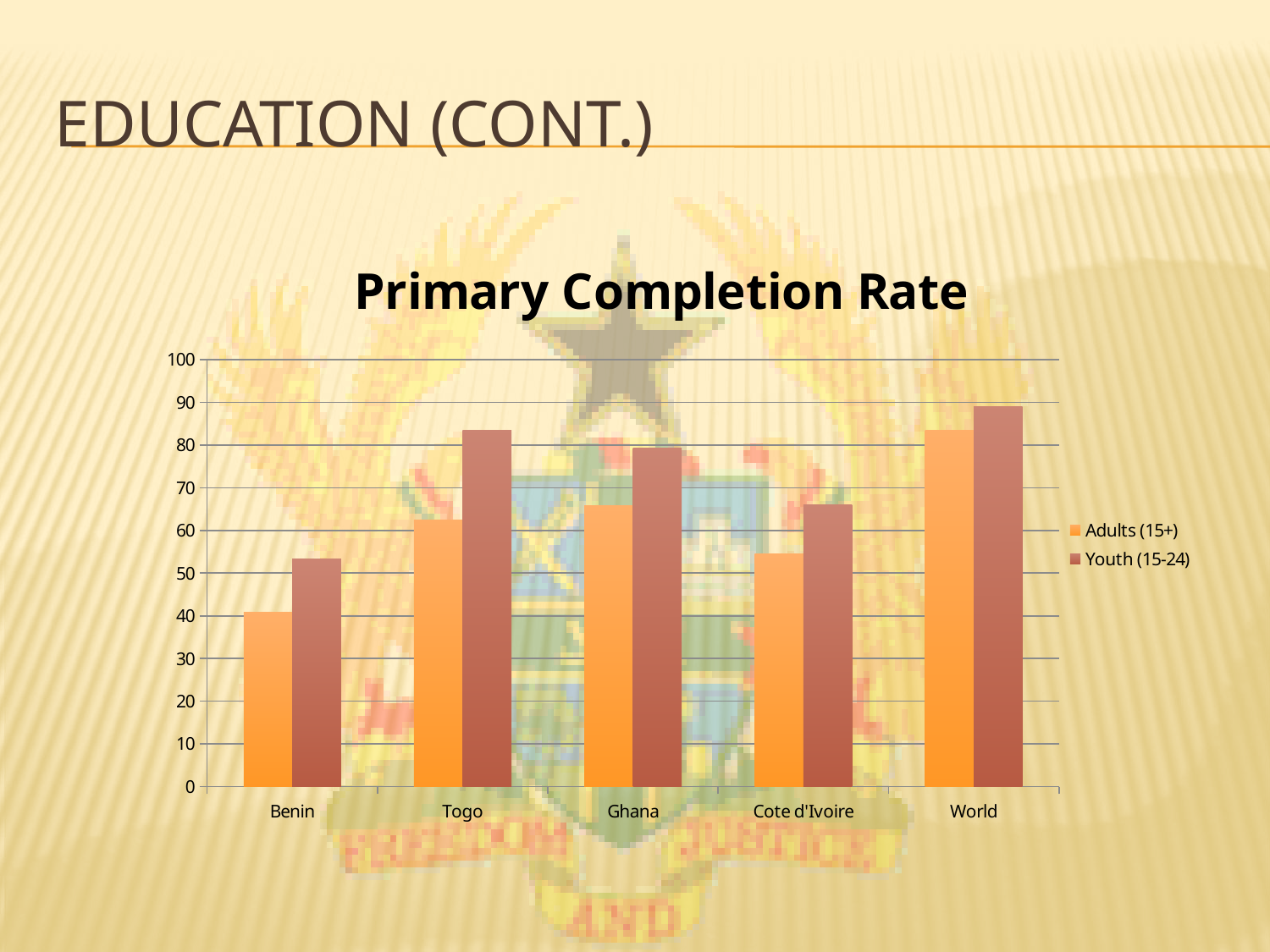
Which category has the lowest Youth (15-24) value? Benin Is the Adults (15+) value for Benin greater or less than 50? less Which is larger for Ghana, the Adults (15+) value or the Youth (15-24) value? Youth (15-24) What kind of chart is shown on the slide? bar chart Is the Youth (15-24) value for Togo greater or less than 80? greater What is the title of the chart? Primary Completion Rate Which category has the lowest Adults (15+) value? Benin How many categories are shown on the x axis? 5 Is the Adults (15+) value for Cote d'Ivoire greater or less than 60? less Which series is shown in orange in the legend? Adults (15+) How many series does the legend list? 2 Which category has the highest Adults (15+) value? World